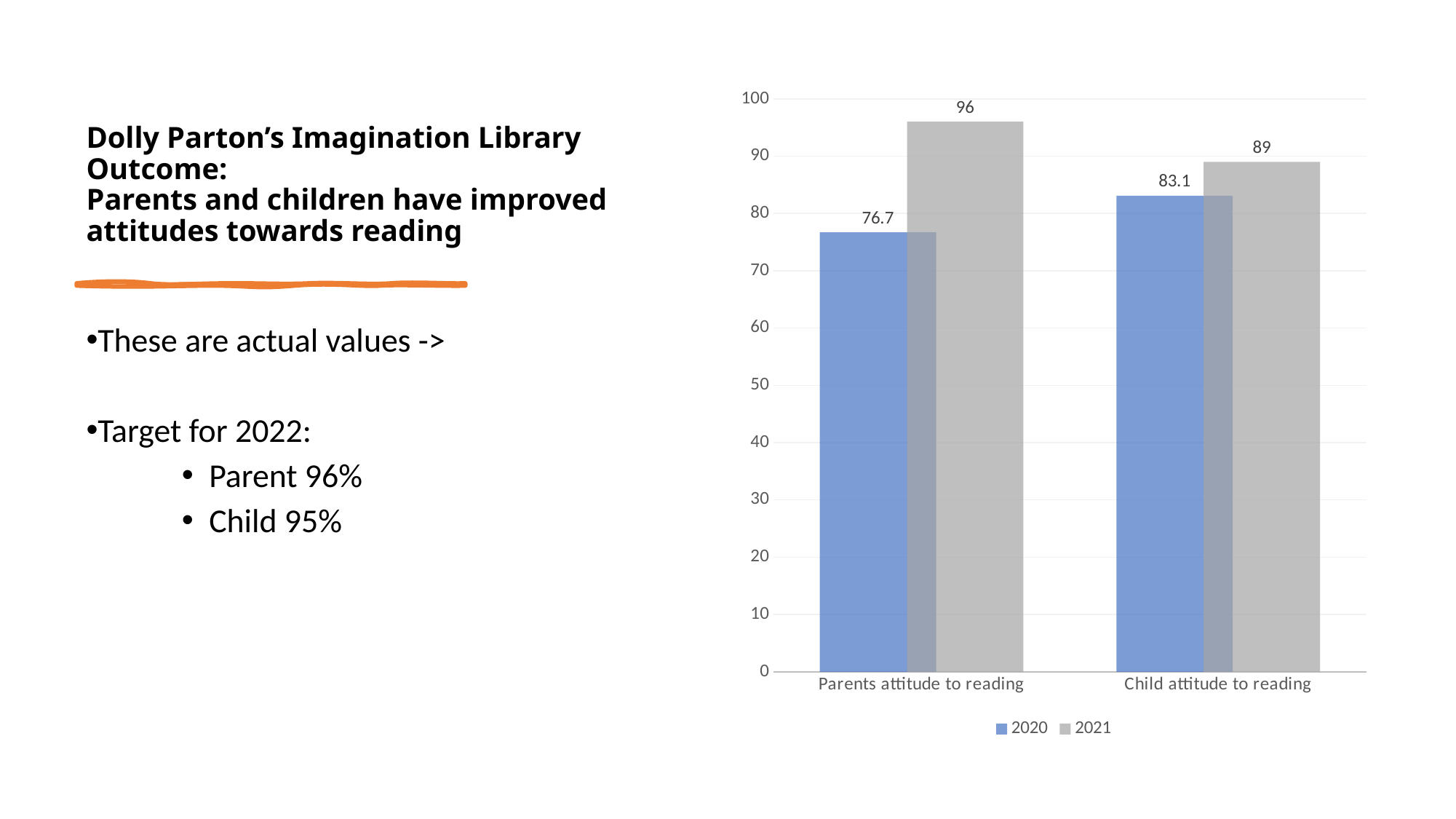
What is the 2021 value for Parents attitude to reading? 96 Which category has the highest 2021 value? Parents attitude to reading What is the 2021 value for Child attitude to reading? 89 What is the 2020 value for Child attitude to reading? 83.1 Which category has the lowest 2020 value? Parents attitude to reading What is the difference between the 2021 and 2020 values for Parents attitude to reading? 19.3 How many series does the legend list? 2 What is the 2020 value for Parents attitude to reading? 76.7 How many categories are shown on the x axis? 2 What kind of chart is shown on the slide? Bar chart Which is larger: the 2020 value for Child attitude to reading or the 2020 value for Parents attitude to reading? Child attitude to reading What is the difference between the 2021 and 2020 values for Child attitude to reading? 5.9